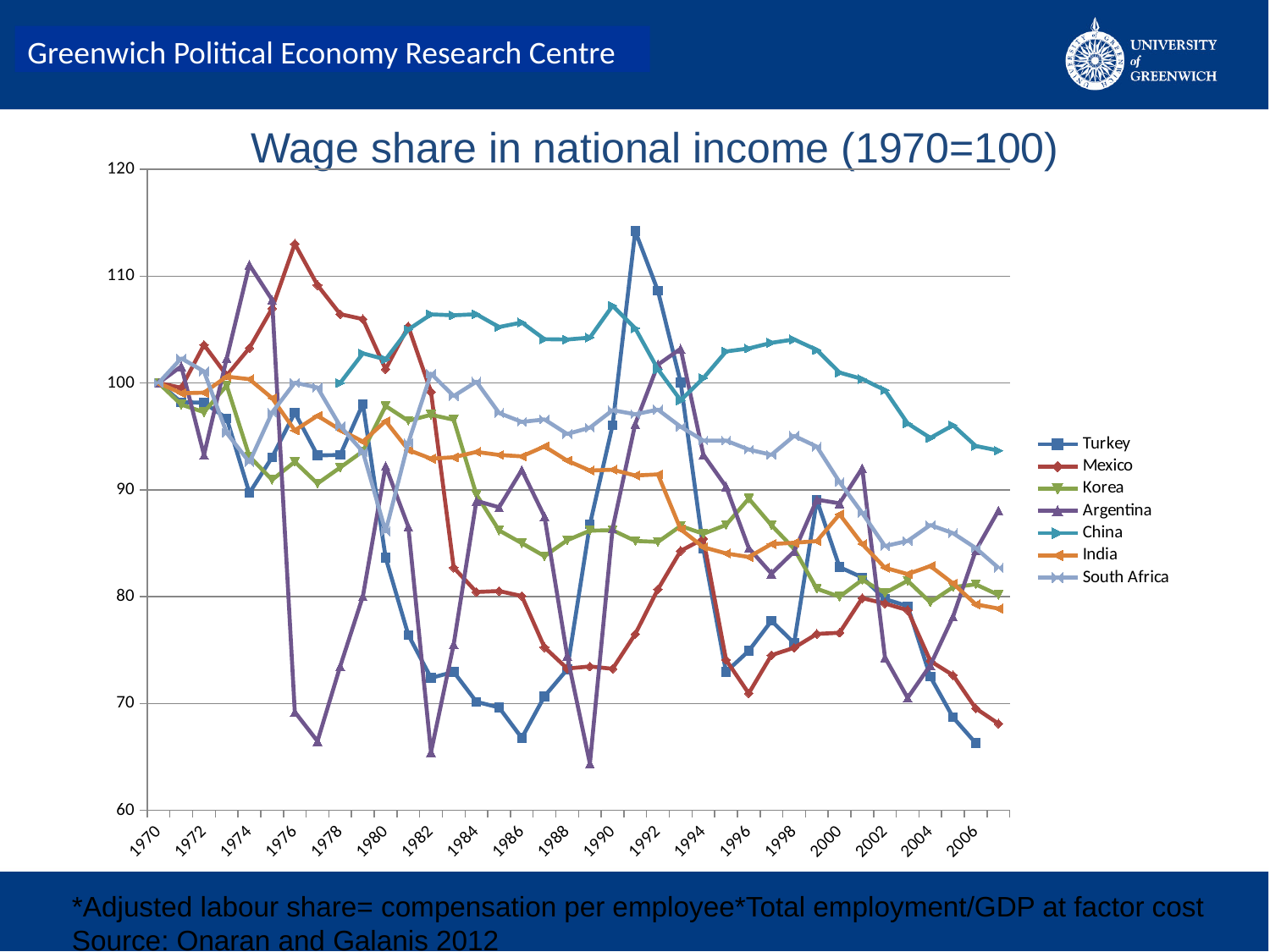
Which series has the highest value in 1991? Turkey Is the value for Mexico in 1976 greater or less than 110? greater What is the title of the chart? Wage share in national income (1970=100) Does the value for Mexico rise or fall between 1976 and 1983? fall How many series does the legend list? 7 Is the value for Turkey in 1991 greater or less than 110? greater Is the value for Korea in 1988 greater or less than 90? less What kind of chart is shown on the slide? line chart Which series is listed last in the legend? South Africa In 2007, which is larger, the value for China or the value for Mexico? China